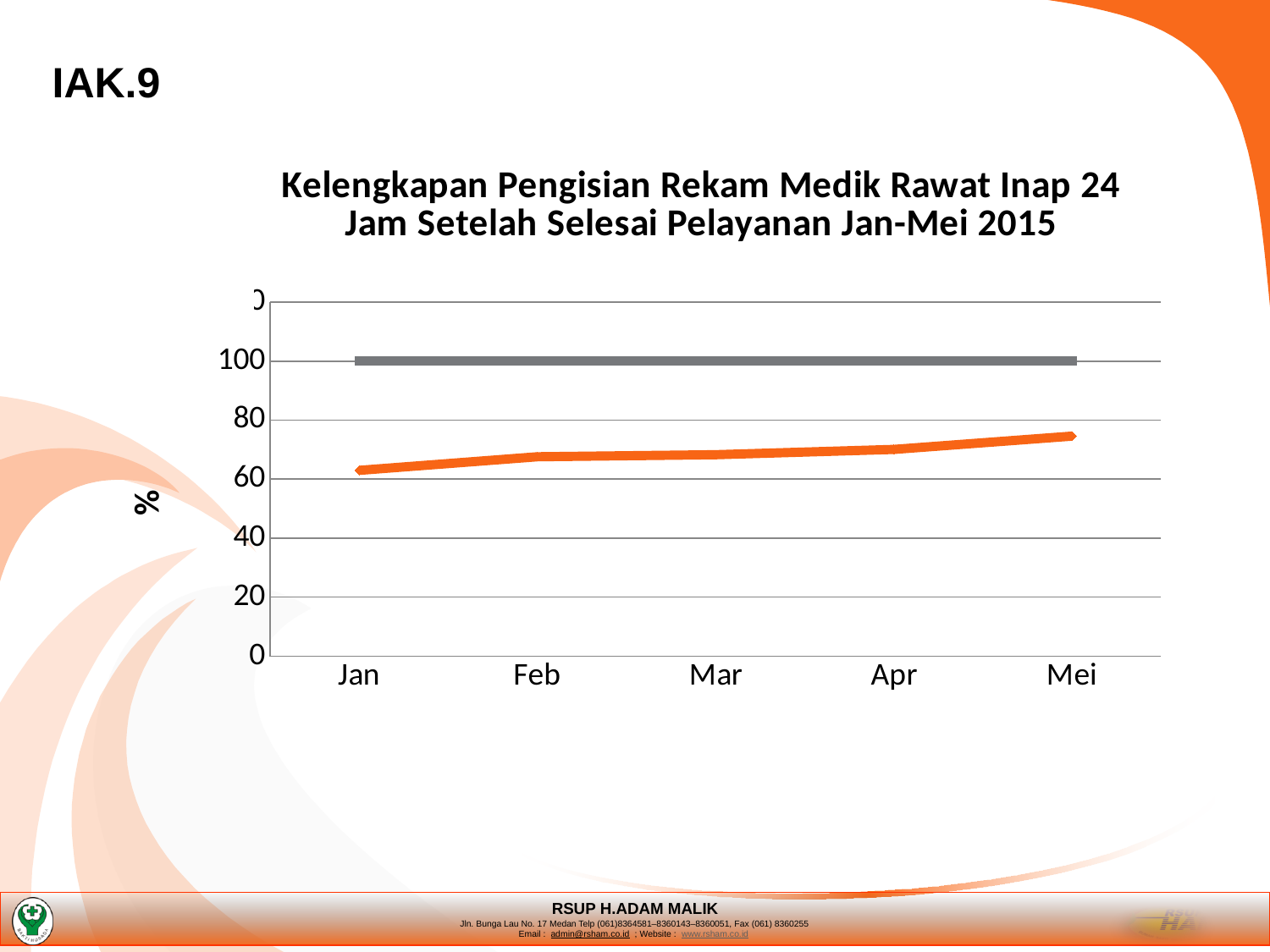
Does the orange line rise or fall from Jan to Mei? rise How many months are shown on the x axis of the chart? 5 Which month has the lowest value on the orange line? Jan Is the value for Jan on the orange line greater or less than 80? less What kind of chart is shown on the slide? line chart Is the value for Mar on the orange line greater or less than 60? greater Is the value for Mei on the orange line greater or less than 80? less Which is larger on the orange line, the value for Mei or the value for Jan? Mei What is the label on the y axis of the chart? % At what value does the flat gray line sit on the y axis? 100 Which month has the highest value on the orange line? Mei